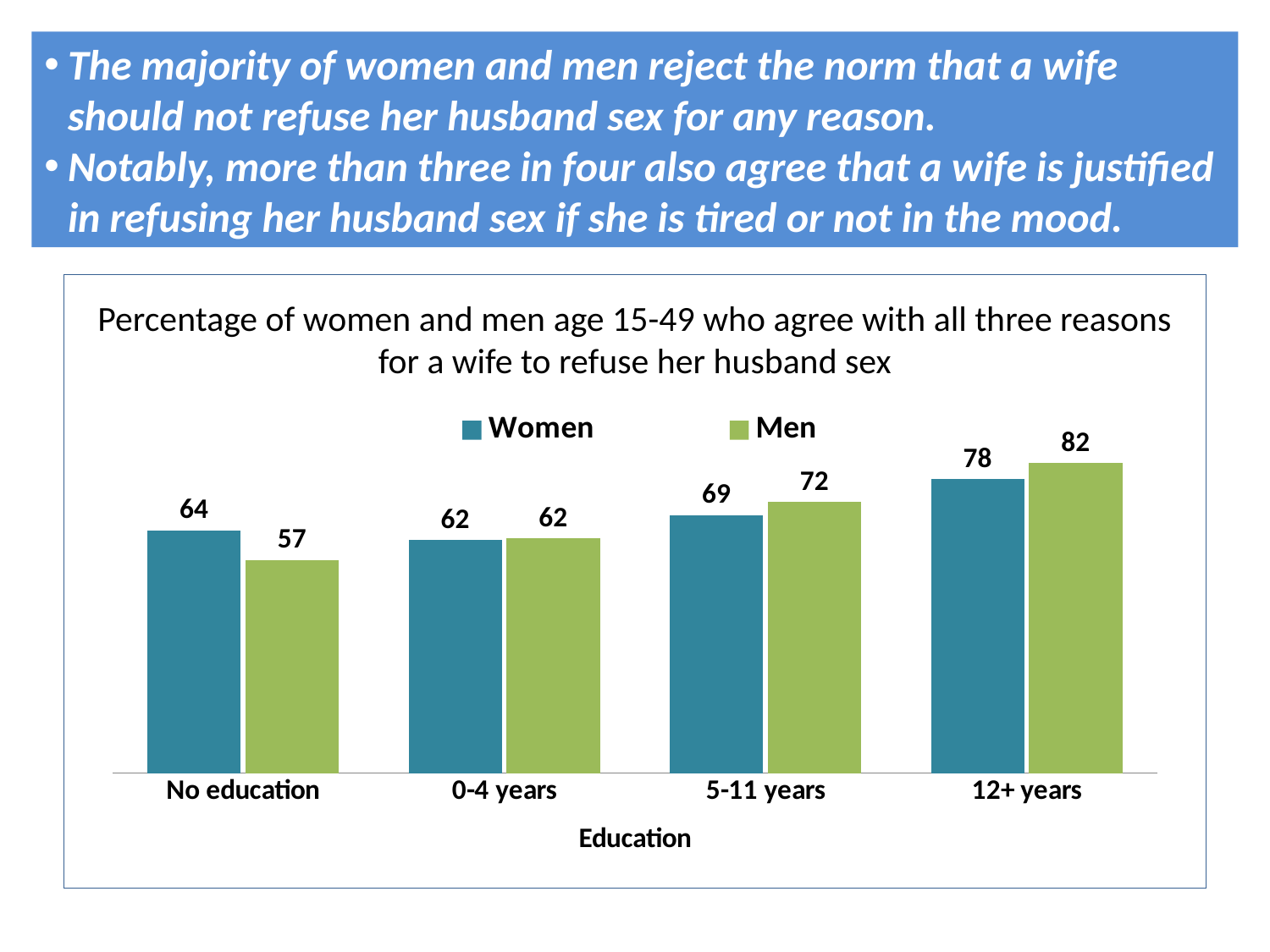
What is the difference between the Men and Women values in the 12+ years category? 4 What kind of chart is shown on the slide? Bar chart What is the value for Men in the No education category? 57 Do the values for Men rise or fall from No education to 12+ years? Rise How many education categories are shown on the x axis? 4 Which education category has the lowest value for Women? 0-4 years What is the difference between the Women and Men values in the No education category? 7 What is the value for Women in the 12+ years category? 78 How many series does the legend list? 2 Which education category has the highest value for Men? 12+ years What is the value for Men in the 5-11 years category? 72 In the 5-11 years category, which is larger, the value for Women or the value for Men? Men